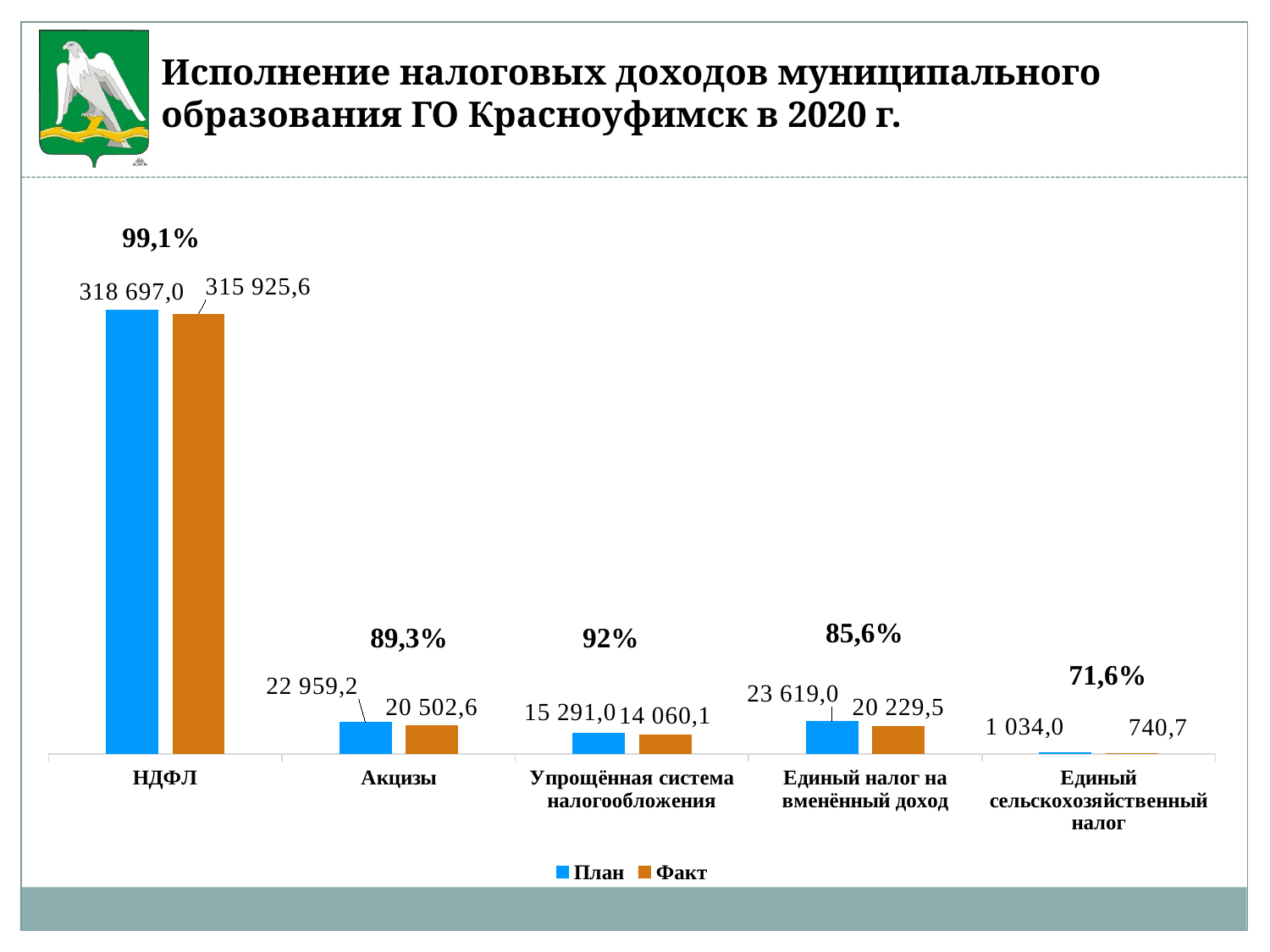
Which is larger: the План value for Акцизы or the План value for Единый налог на вменённый доход? Единый налог на вменённый доход What is the Факт value for Акцизы? 20 502,6 Which category has the lowest План value? Единый сельскохозяйственный налог Which category has the highest Факт value? НДФЛ What is the Факт value for Единый сельскохозяйственный налог? 740,7 What is the difference between the План and Факт values for Упрощённая система налогообложения? 1 230,9 What kind of chart is shown on the slide? bar chart What percentage is shown above the Единый налог на вменённый доход bars? 85,6% How many series does the legend list? 2 What is the План value for НДФЛ? 318 697,0 How many categories are shown on the x axis? 5 Which colour represents the Факт series in the legend? orange